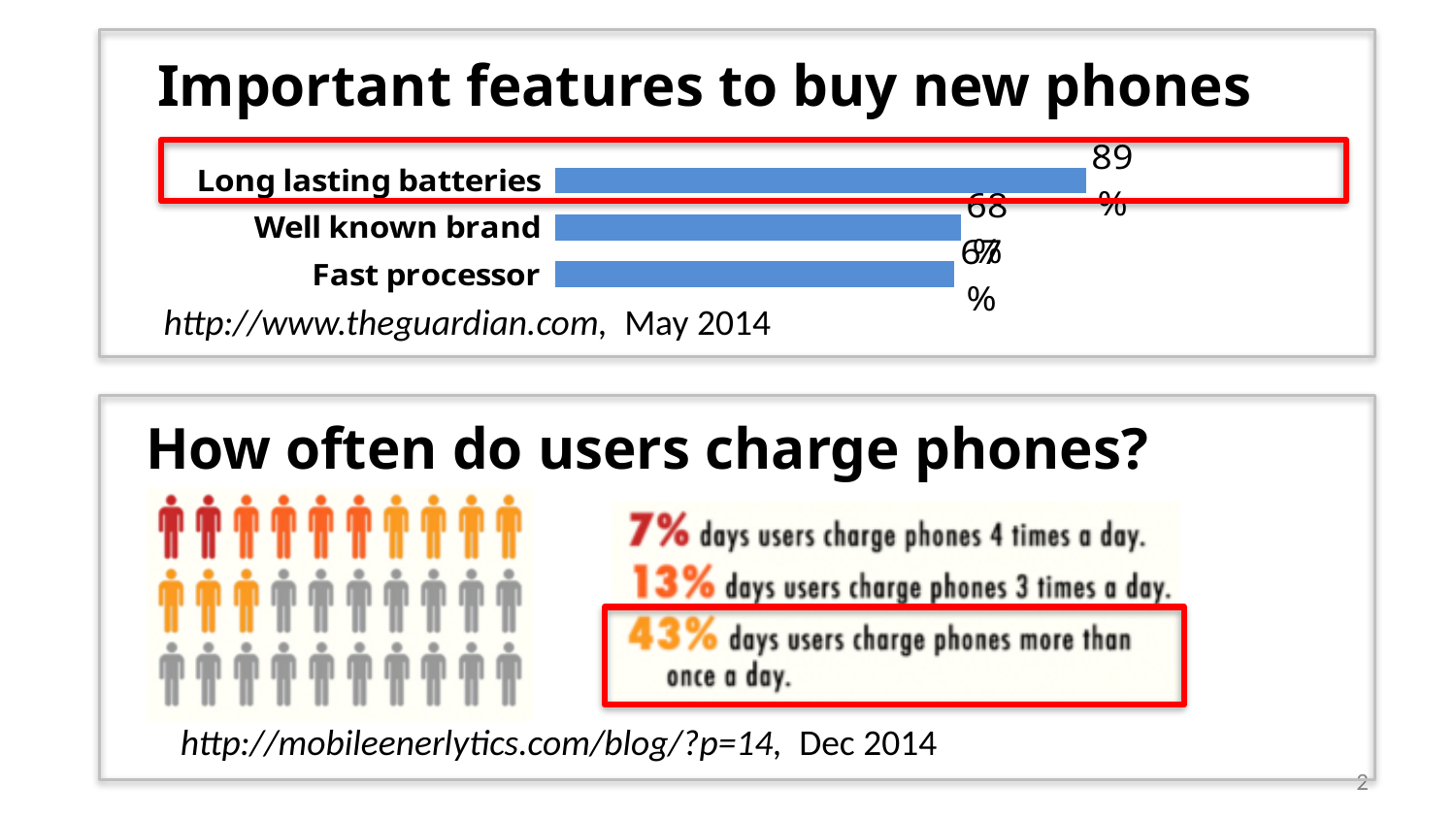
In the 'How often do users charge phones?' graphic, what percentage of days do users charge phones 4 times a day? 7% In the 'Important features to buy new phones' chart, what is the value for Long lasting batteries? 89% In the 'Important features to buy new phones' chart, which category is highlighted with a red box? Long lasting batteries In the 'Important features to buy new phones' chart, which feature has the highest value? Long lasting batteries In the 'How often do users charge phones?' graphic, what is the difference between the share for more than once a day and the share for 3 times a day? 30 percentage points In the 'Important features to buy new phones' chart, how many features are listed? 3 In the 'How often do users charge phones?' graphic, which is larger: the share for 3 times a day or the share for 4 times a day? 3 times a day In the 'Important features to buy new phones' chart, which is larger: Long lasting batteries or Fast processor? Long lasting batteries In the 'How often do users charge phones?' graphic, what percentage of days do users charge phones more than once a day? 43% In the 'Important features to buy new phones' chart, what is the difference between Long lasting batteries and Well known brand? 21 percentage points In the 'Important features to buy new phones' chart, what is the value for Well known brand? 68% What kind of chart is shown under 'Important features to buy new phones'? Bar chart